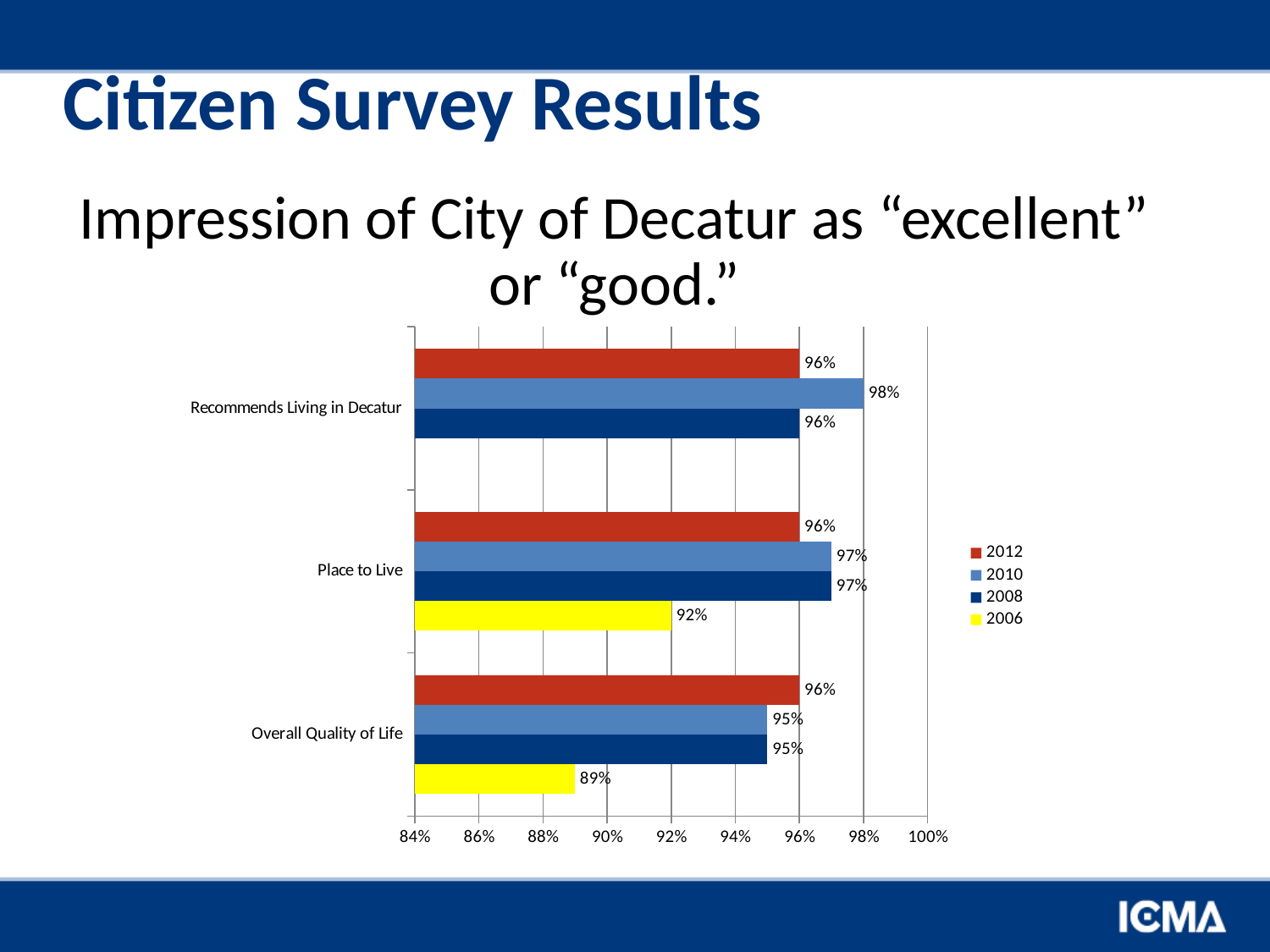
What is the 2012 value for Place to Live? 96% Which is larger for Place to Live: the 2010 value or the 2006 value? 2010 What is the 2006 value for Overall Quality of Life? 89% What is the difference between the 2012 and 2006 values for Overall Quality of Life? 7% How many series does the legend list? 4 How many categories are shown on the chart? 3 What kind of chart is shown on the slide? Bar chart What is the 2006 value for Place to Live? 92% Which colour represents the 2006 series in the legend? Yellow Which year has the highest value for Recommends Living in Decatur? 2010 What is the 2010 value for Recommends Living in Decatur? 98% Which year has the lowest value for Overall Quality of Life? 2006